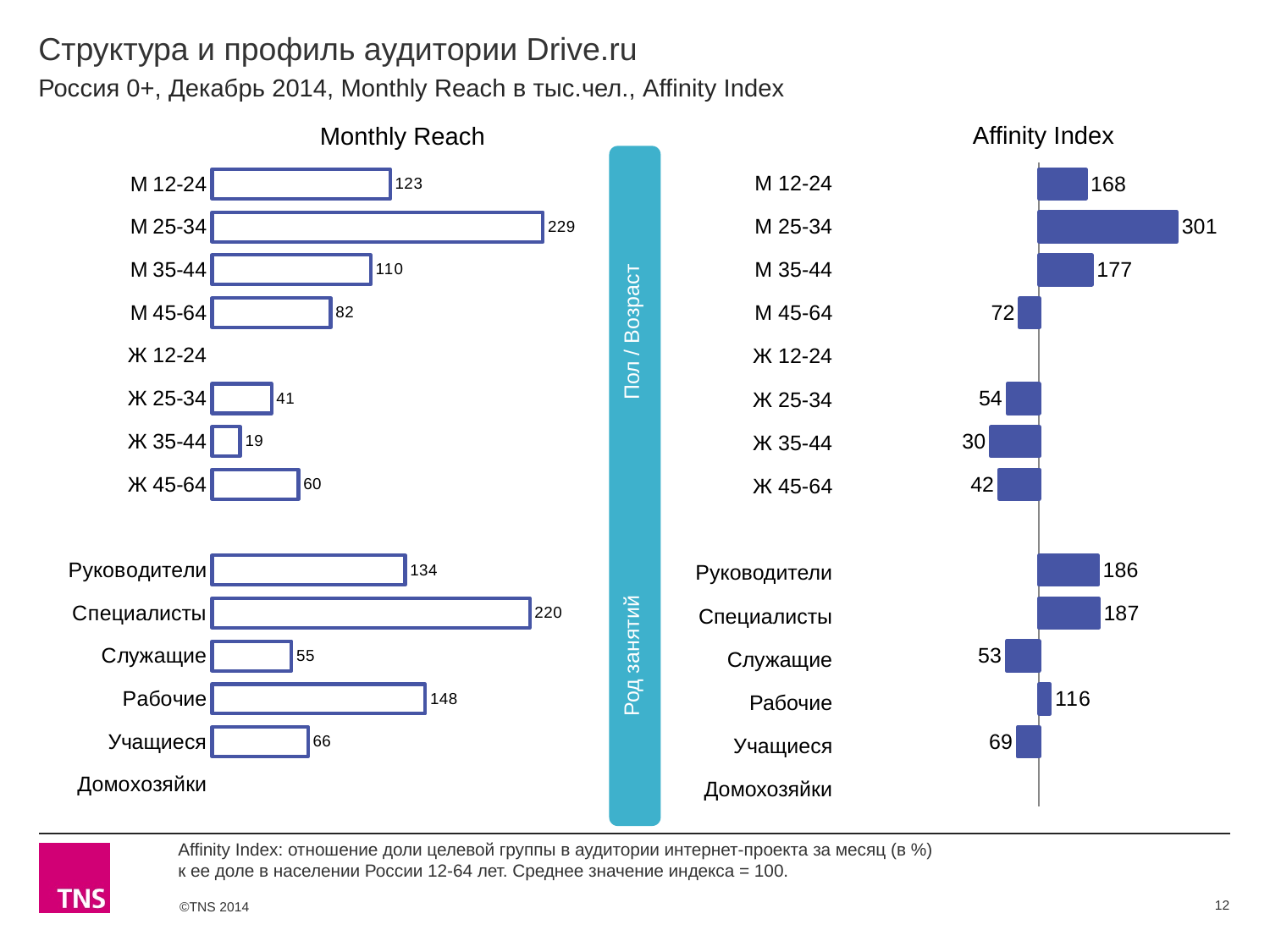
In the Monthly Reach chart, what is the value for Рабочие? 148 In the Affinity Index chart, which category has the highest value? М 25-34 What type of chart is the Monthly Reach chart? Bar chart In the Monthly Reach chart, what is the value for М 25-34? 229 In the Monthly Reach chart, what is the difference between Специалисты and Руководители? 86 In the Affinity Index chart, what is the difference between М 25-34 and М 35-44? 124 In the Affinity Index chart, which labelled category has the lowest value? Ж 35-44 In the Monthly Reach chart, which is larger: М 12-24 or М 35-44? М 12-24 In the Affinity Index chart, what is the value for Руководители? 186 In the Affinity Index chart, which is larger: Рабочие or Учащиеся? Рабочие What is the title of the chart on the right side of the slide? Affinity Index In the Monthly Reach chart, which labelled category has the lowest value? Ж 35-44